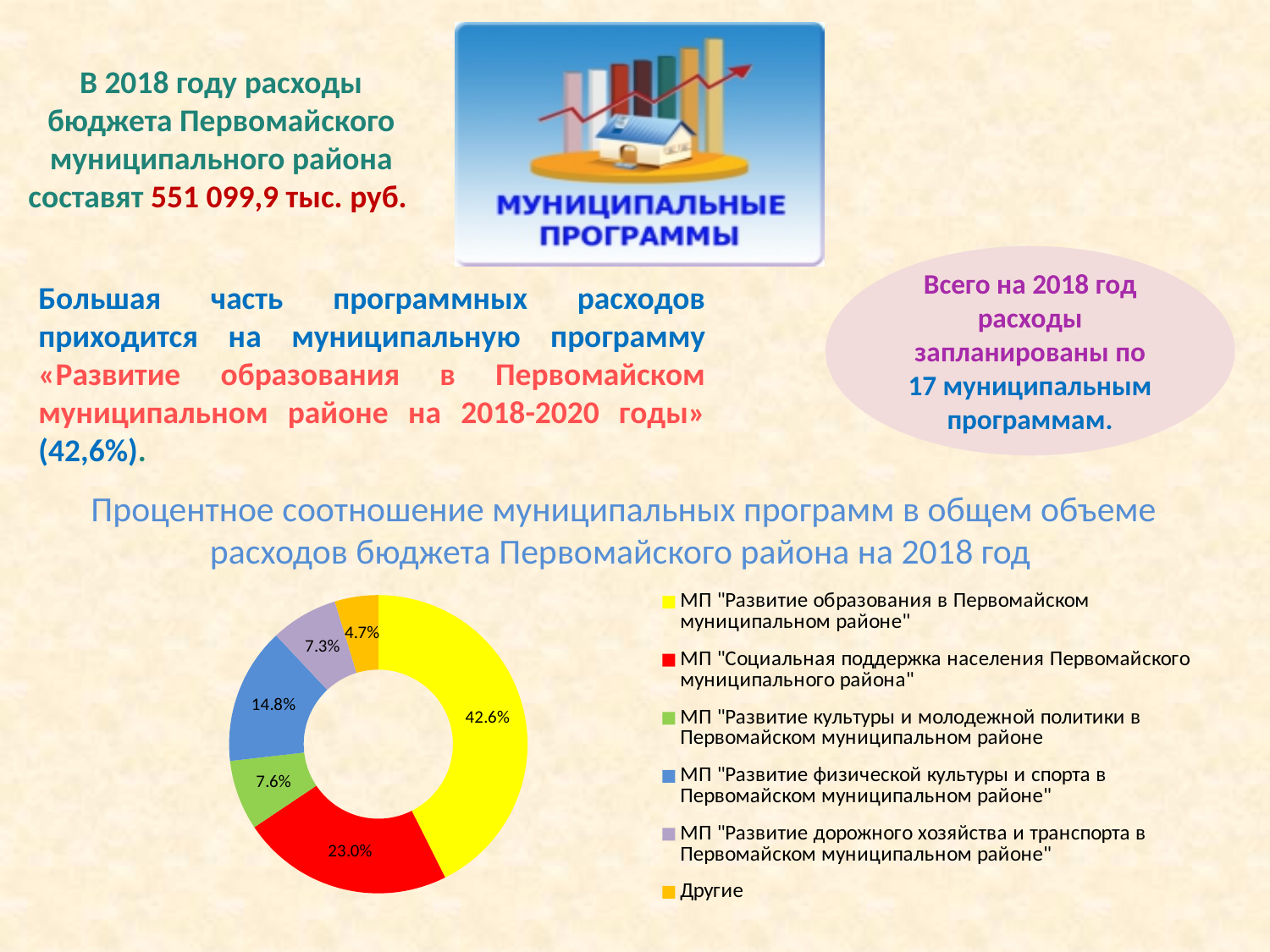
What is the title of the chart? Процентное соотношение муниципальных программ в общем объеме расходов бюджета Первомайского района на 2018 год Which program has the largest share in the chart? МП "Развитие образования в Первомайском муниципальном районе" What share is shown for МП "Развитие физической культуры и спорта в Первомайском муниципальном районе"? 14.8% What share is shown for МП "Социальная поддержка населения Первомайского муниципального района"? 23.0% What share is shown for МП "Развитие дорожного хозяйства и транспорта в Первомайском муниципальном районе"? 7.3% What share of the chart does МП "Развитие образования в Первомайском муниципальном районе" have? 42.6% Which is larger: the share for МП "Развитие культуры и молодежной политики" or the share for МП "Развитие дорожного хозяйства и транспорта"? МП "Развитие культуры и молодежной политики" (7.6%) How many slices does the chart have? 6 Which slice has the smallest share in the chart? Другие What share is shown for the "Другие" slice? 4.7% What kind of chart is shown on the slide? Doughnut (pie) chart What is the difference between the shares of МП "Развитие образования" and МП "Социальная поддержка населения"? 19.6%